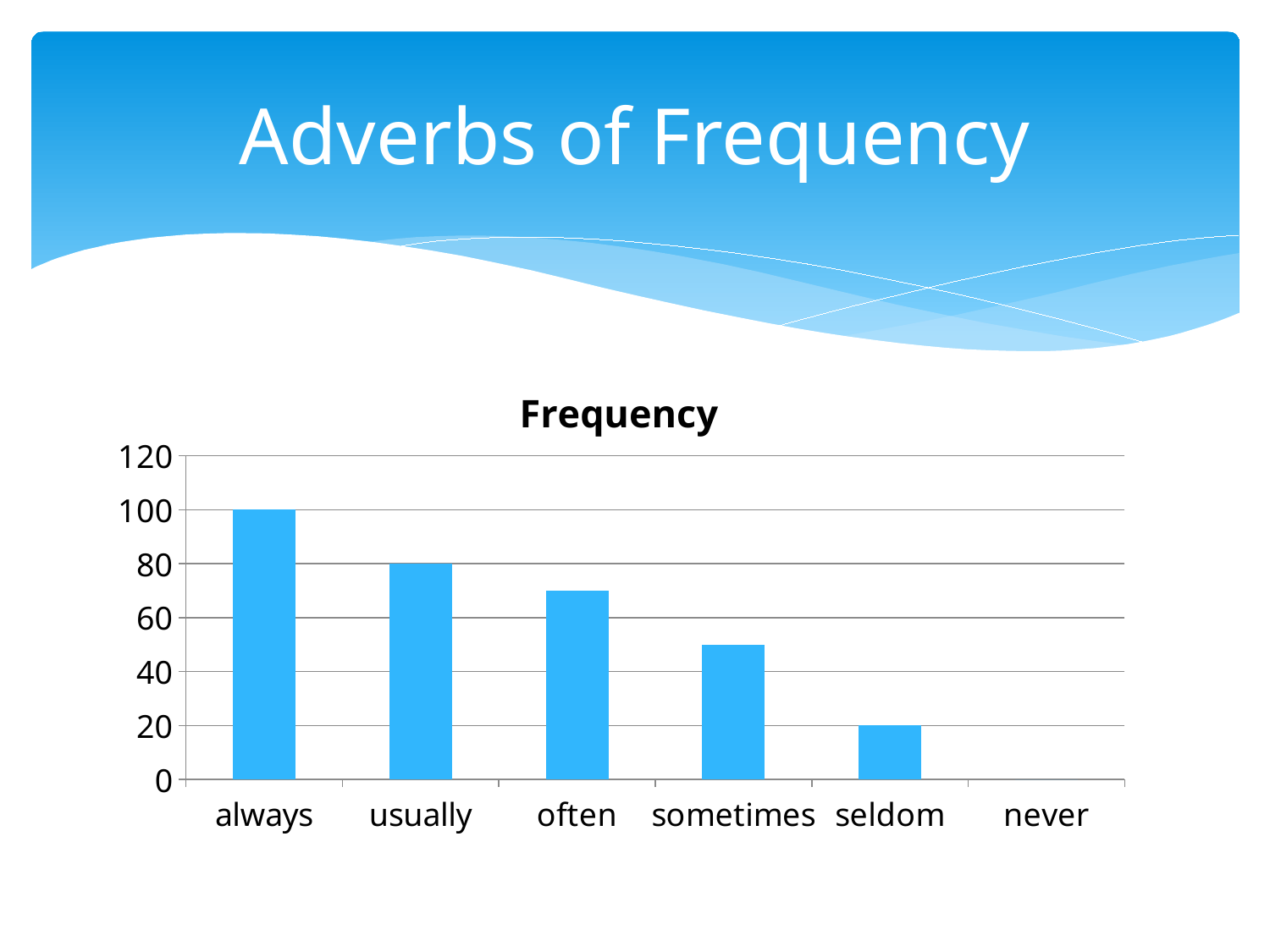
What is the value for "always" in the Frequency chart? 100 What is the difference between the values for "usually" and "seldom"? 60 What kind of chart is shown on the slide? bar chart Is the value for "often" greater or less than 60? greater What is the value for "usually" in the Frequency chart? 80 Is the value for "sometimes" greater or less than 60? less How many categories are shown on the x axis of the Frequency chart? 6 Which category has the highest value in the Frequency chart? always Which is larger, the value for "often" or the value for "sometimes"? often Which category has the lowest value in the Frequency chart? never What is the value for "seldom" in the Frequency chart? 20 What is the difference between the values for "always" and "usually"? 20